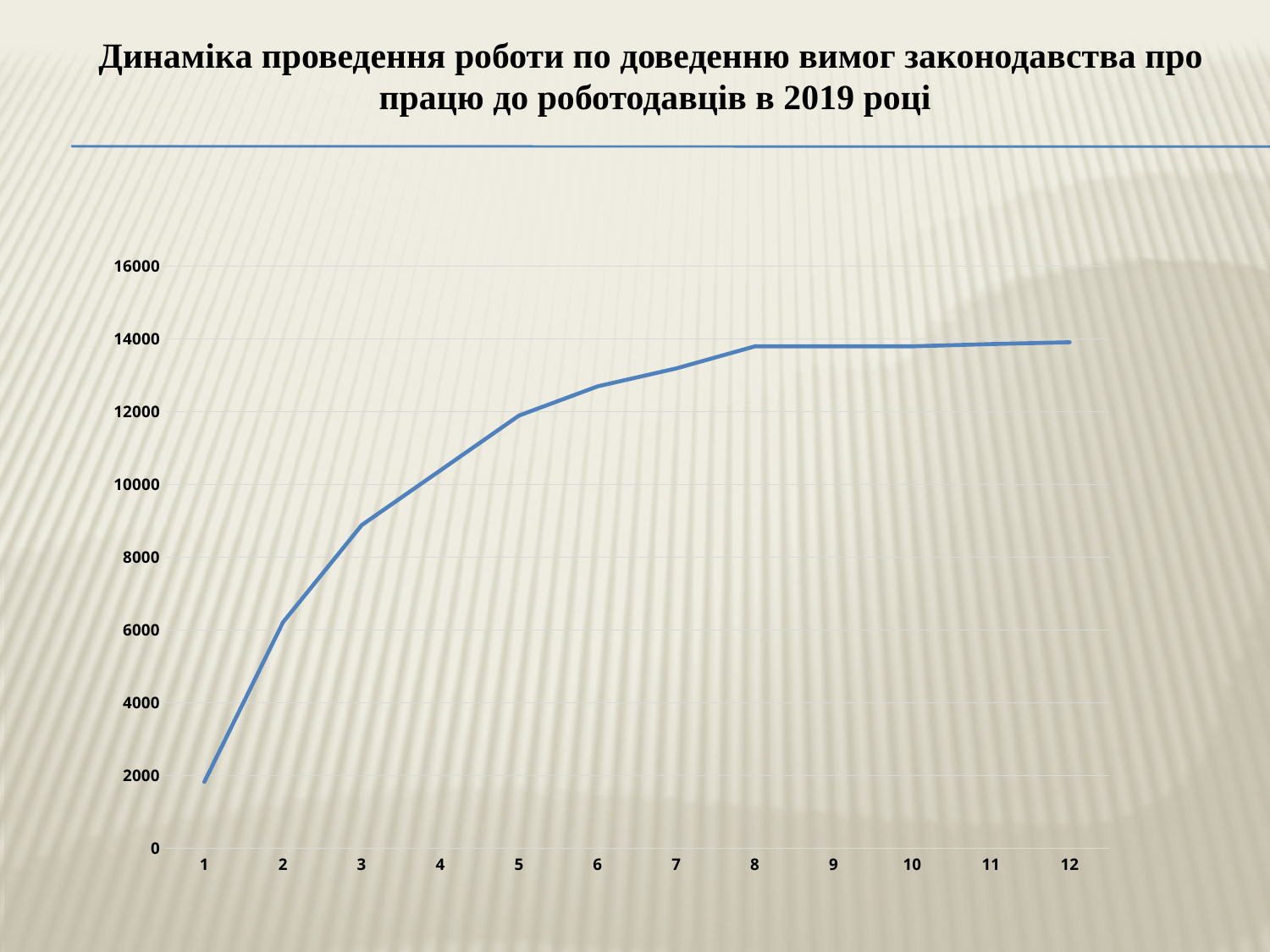
Do the values rise or fall from point 1 to point 12 along the x axis? rise Which is larger, the value at point 2 or the value at point 3? point 3 Which x-axis point has the lowest value? 1 Is the value at point 1 greater or less than 2000? less How many points are plotted along the x axis? 12 Which is larger, the value at point 1 or the value at point 5? point 5 Is the value at point 3 greater or less than 8000? greater What kind of chart is shown on the slide? line chart Is the value at point 4 greater or less than 10000? greater What is the highest value shown on the y axis? 16000